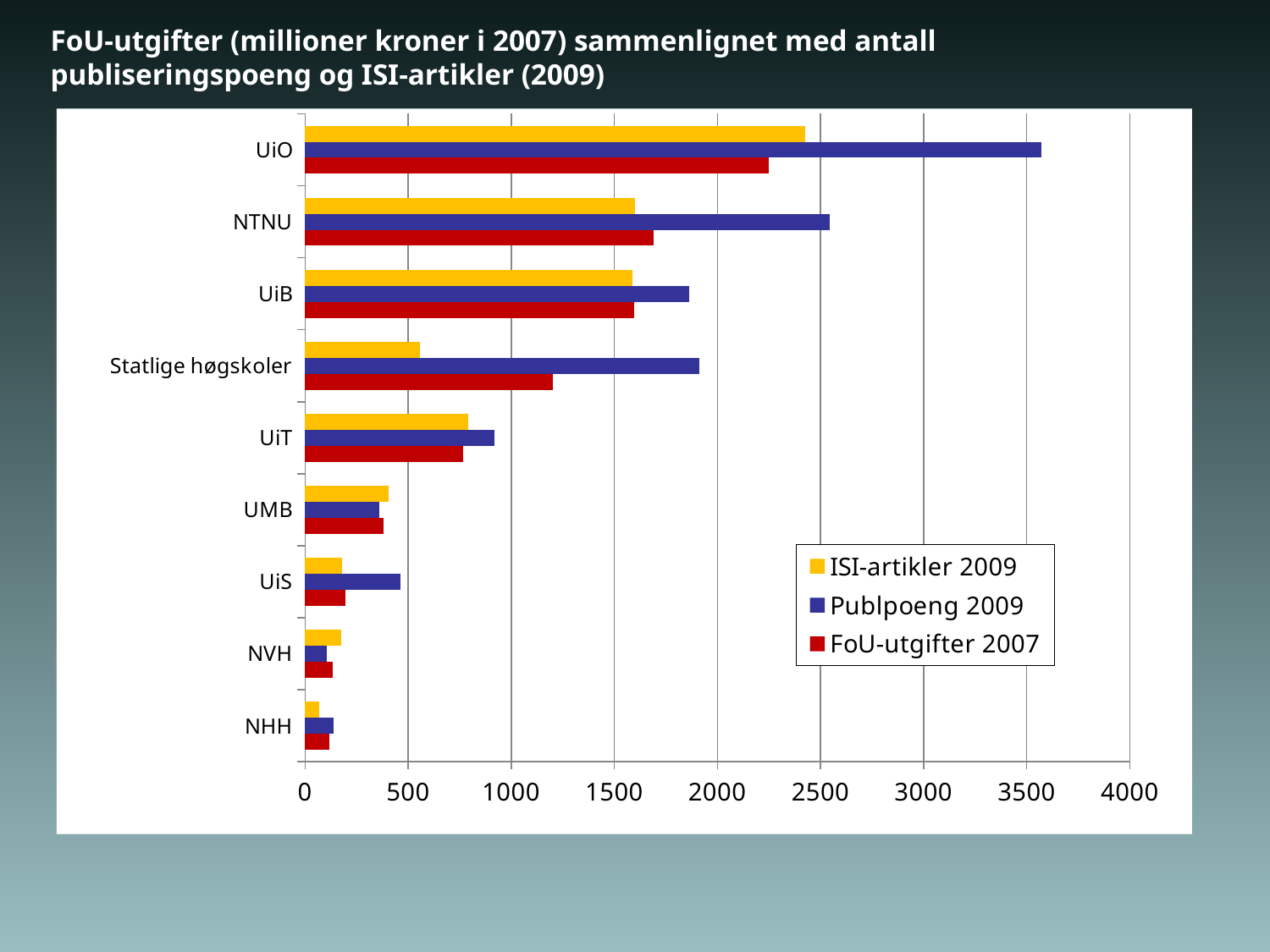
How many series does the legend list? 3 How many institutions (categories) are listed on the chart? 9 What colour represents FoU-utgifter 2007 in the legend? red Which institution has the highest value for Publpoeng 2009? UiO Which institution has the lowest value for ISI-artikler 2009? NHH Is the FoU-utgifter 2007 value for Statlige høgskoler greater or less than 1000? greater Is the Publpoeng 2009 value for NTNU greater or less than 2000? greater What kind of chart is shown on the slide? bar chart For Statlige høgskoler, which is larger: Publpoeng 2009 or ISI-artikler 2009? Publpoeng 2009 Which has the larger ISI-artikler 2009 value: UiO or NTNU? UiO Is the ISI-artikler 2009 value for UiT greater or less than 1000? less